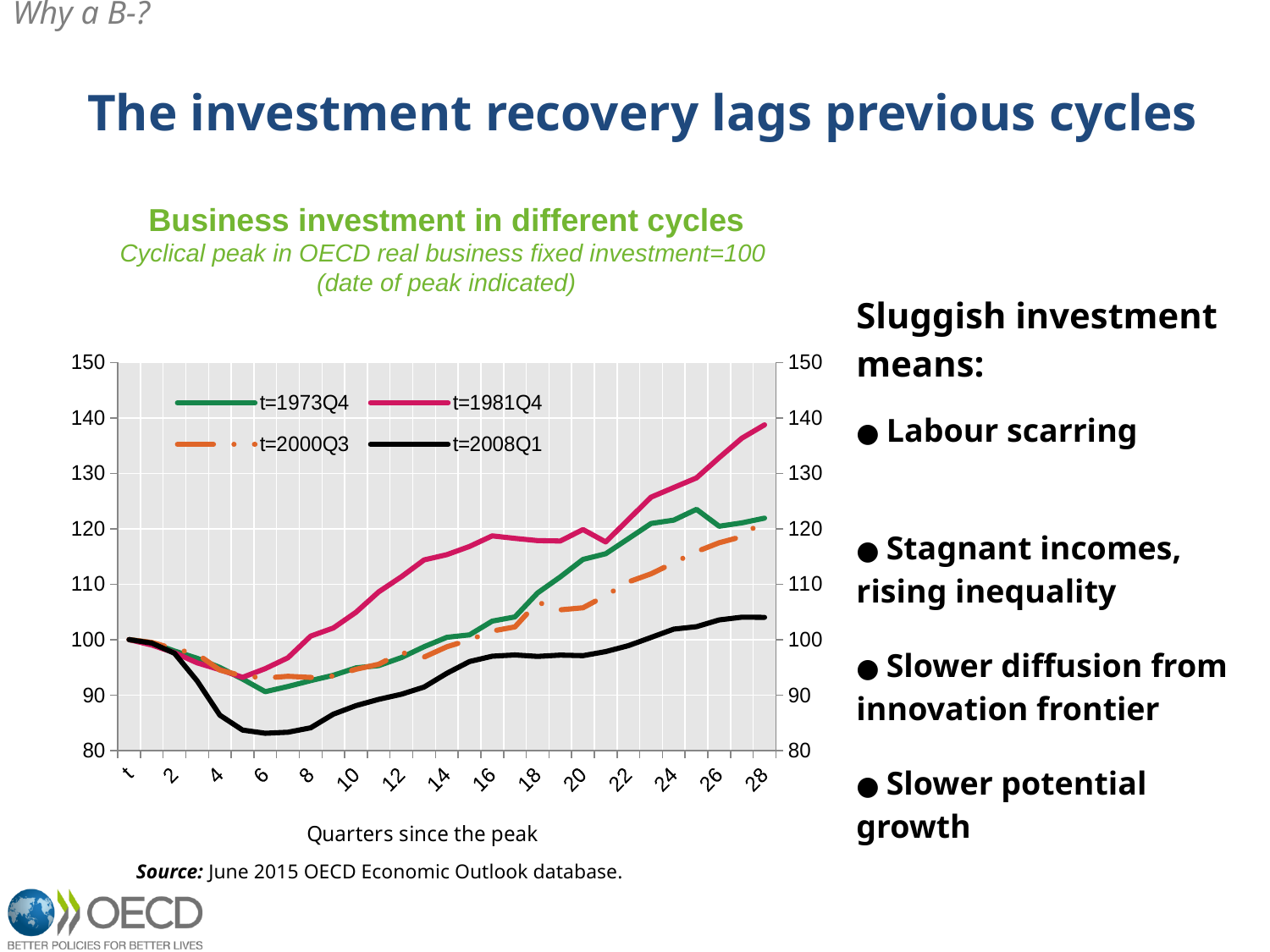
Is the value for t=1981Q4 at quarter 28 greater or less than 130? greater How many series does the legend list? 4 What value do all four series take at quarter t (the peak)? 100 What is the title of the x axis? Quarters since the peak Does the t=2008Q1 series rise or fall between quarter 6 and quarter 28? rise Which series does the legend list? t=1973Q4, t=1981Q4, t=2000Q3, t=2008Q1 Which series is highest at quarter 28? t=1981Q4 Is the lowest value reached by the t=2008Q1 series greater or less than 90? less Which series is lowest at quarter 28? t=2008Q1 At quarter 20, which series has the larger value, t=1973Q4 or t=2008Q1? t=1973Q4 Is the value for t=2008Q1 at quarter 28 greater or less than 110? less What kind of chart is shown on the slide? line chart